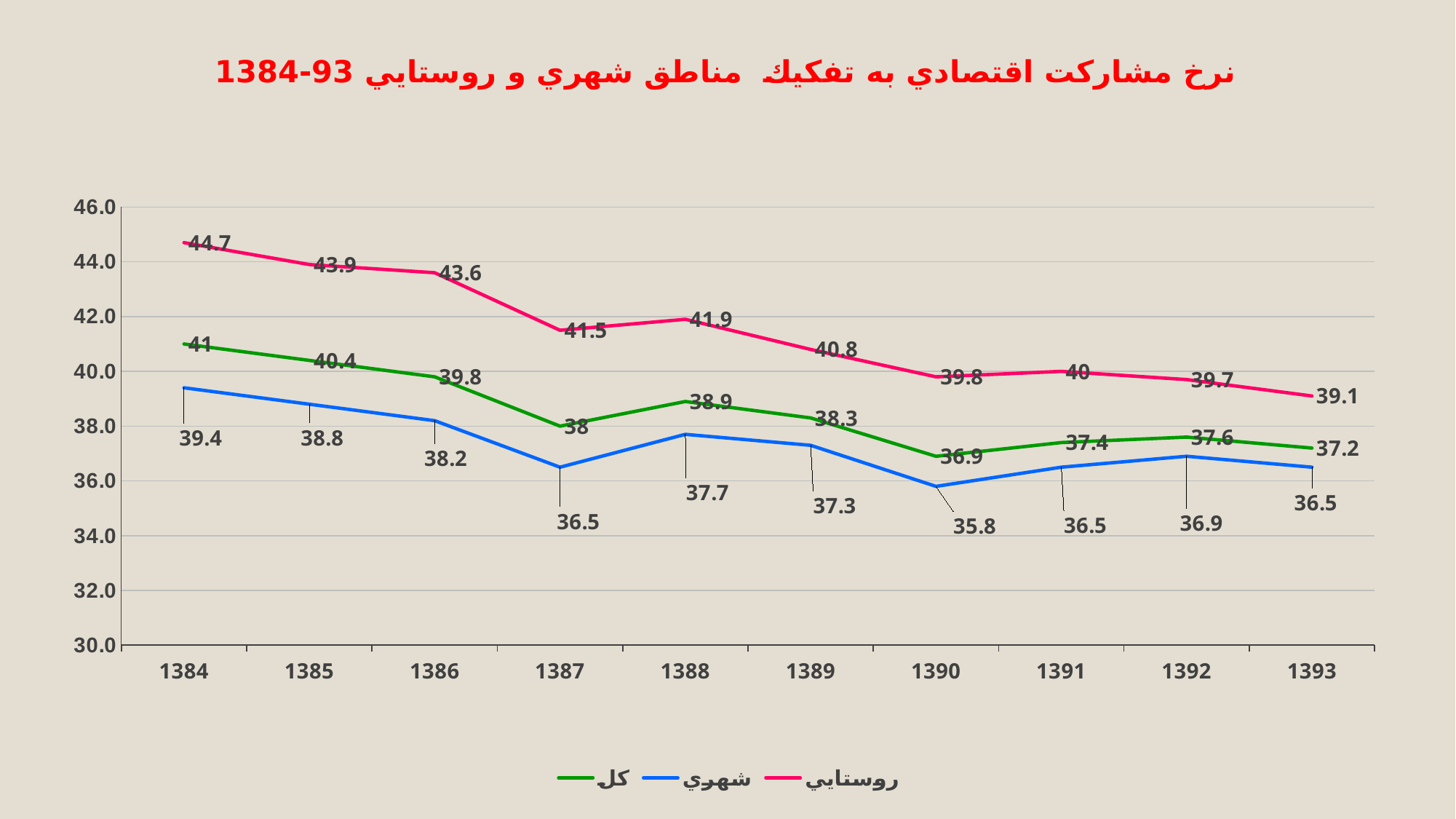
What is the difference between the روستايي (rural) and شهري (urban) values in 1387? 5 How many series does the legend list? 3 Which colour is used for the شهري (urban) series? blue In which year is the شهري (urban) series at its highest? 1384 Overall, does the روستايي (rural) series rise or fall from 1384 to 1393? fall What is the value of the روستايي (rural) series in 1384? 44.7 Which series has the higher value in 1391, كل (total) or شهري (urban)? كل (total) In which year is the روستايي (rural) series at its lowest? 1393 What is the value of the كل (total) series in 1393? 37.2 What type of chart is shown on the slide? line chart How many years are shown on the x axis? 10 What is the value of the شهري (urban) series in 1390? 35.8